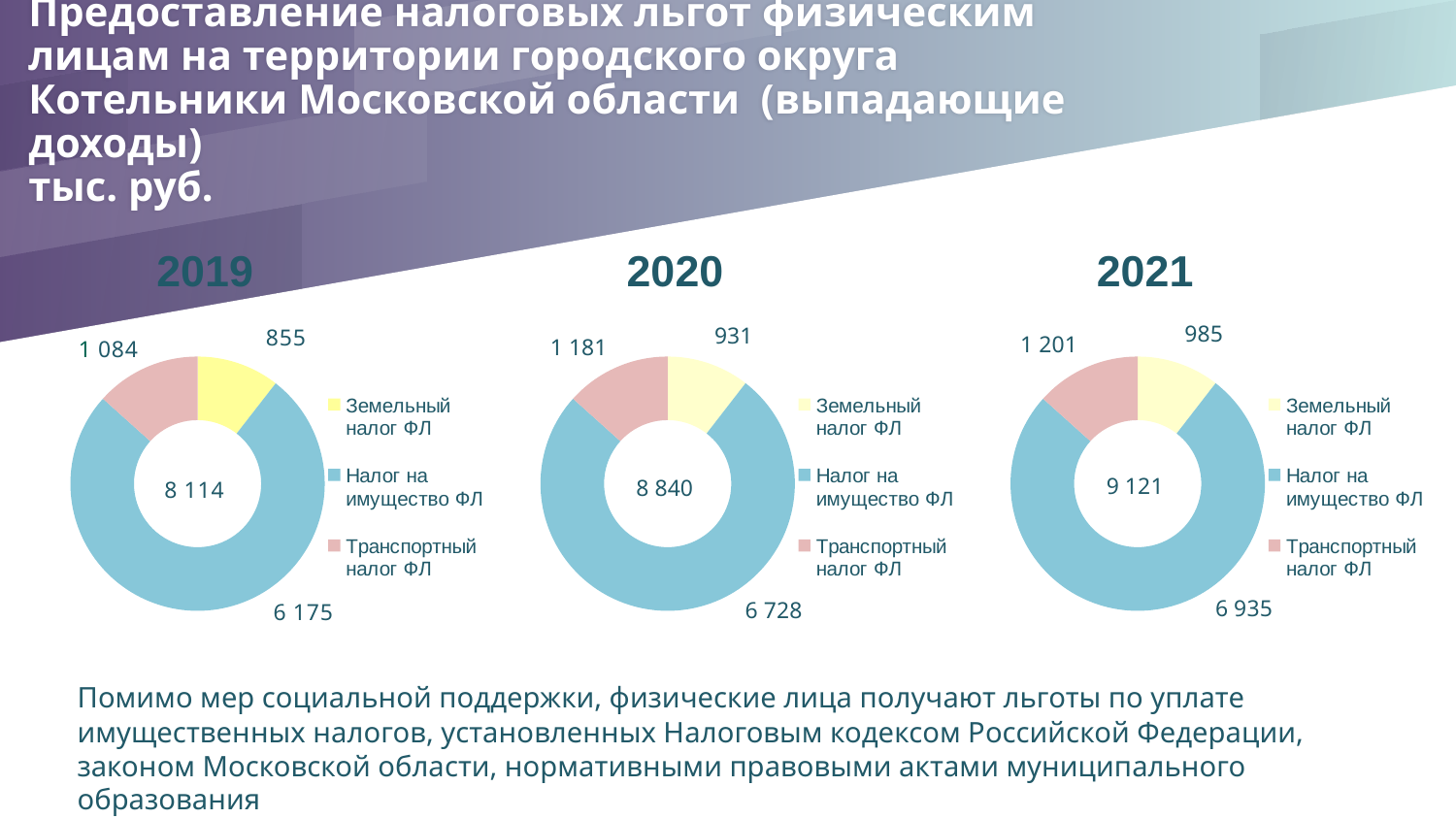
In the 2019 chart, what is the value for Налог на имущество ФЛ? 6 175 How does the value for Налог на имущество ФЛ change from 2019 to 2021 across the charts? It rises In the 2021 chart, which is larger: Транспортный налог ФЛ or Земельный налог ФЛ? Транспортный налог ФЛ In the 2021 chart, what is the value for Земельный налог ФЛ? 985 What type of chart is used for each year on the slide? Doughnut (pie) chart In the 2020 chart, what is the difference between Налог на имущество ФЛ and Транспортный налог ФЛ? 5 547 Which colour represents Земельный налог ФЛ in the charts? Yellow In the 2020 chart, what is the value for Транспортный налог ФЛ? 1 181 How many categories does each chart's legend list? 3 What is the total shown in the centre of the 2020 chart? 8 840 In the 2019 chart, which category has the smallest value? Земельный налог ФЛ In the 2021 chart, which category has the largest value? Налог на имущество ФЛ